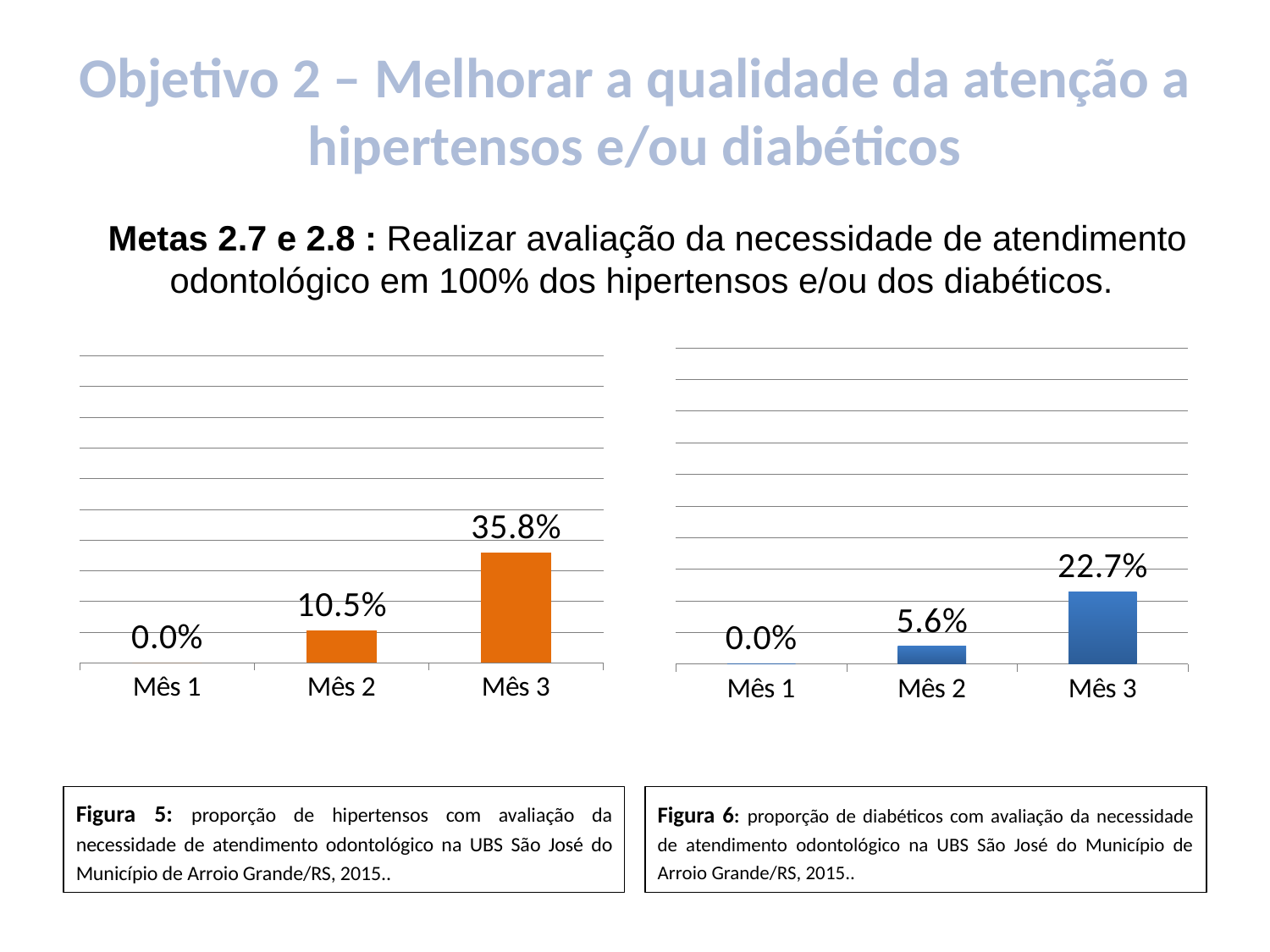
In the right chart (Figura 6), do the values rise or fall from Mês 1 to Mês 3? Rise In the right chart (Figura 6), what is the value for Mês 2? 5.6% In the left chart (Figura 5), which month has the highest value? Mês 3 What kind of chart is the left chart (Figura 5)? Bar chart How many categories are shown on the x axis of the right chart (Figura 6)? 3 In the right chart (Figura 6), what is the value for Mês 3? 22.7% In the right chart (Figura 6), what is the difference between the values for Mês 3 and Mês 2? 17.1% In the left chart (Figura 5), what is the value for Mês 2? 10.5% In the left chart (Figura 5), what is the difference between the values for Mês 3 and Mês 2? 25.3% Which is larger: the Mês 3 value in the left chart (Figura 5) or the Mês 3 value in the right chart (Figura 6)? Left chart (Figura 5), 35.8% In the right chart (Figura 6), which month has the lowest value? Mês 1 In the left chart (Figura 5), what is the value for Mês 3? 35.8%